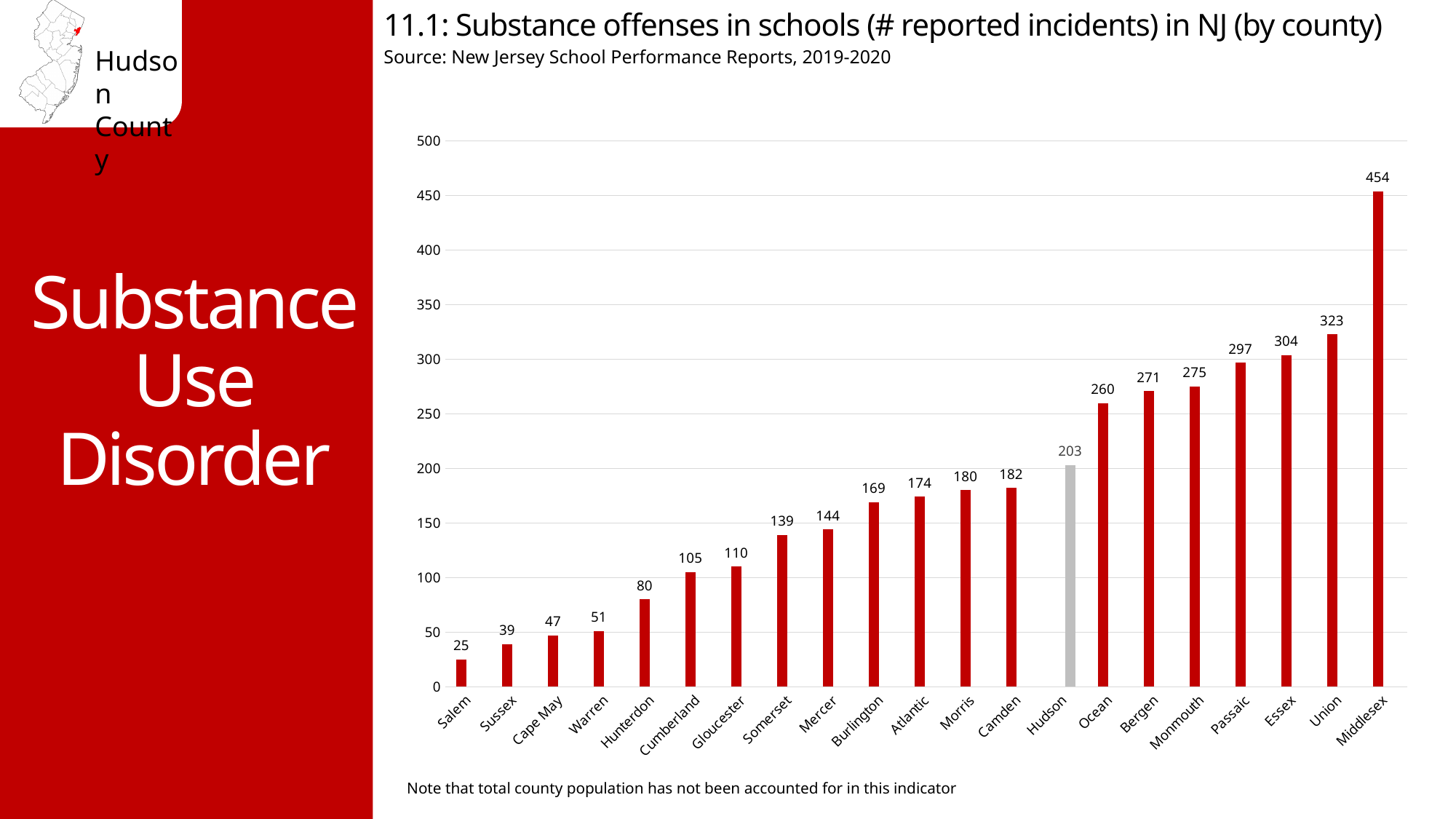
What kind of chart is shown on the slide? Bar chart Which county has the highest number of reported incidents? Middlesex Which county's bar is coloured grey instead of red? Hudson Which has a higher value, Bergen or Monmouth? Monmouth What is the number of reported substance offense incidents in schools for Hudson County? 203 What is the value shown for Middlesex? 454 What is the difference between the values for Hudson and Camden? 21 Which county has the lowest number of reported incidents? Salem What is the value shown for Salem? 25 How many counties are shown on the x axis? 21 What is the difference between the values for Middlesex and Union? 131 Do the values rise or fall moving from left to right along the x axis? Rise